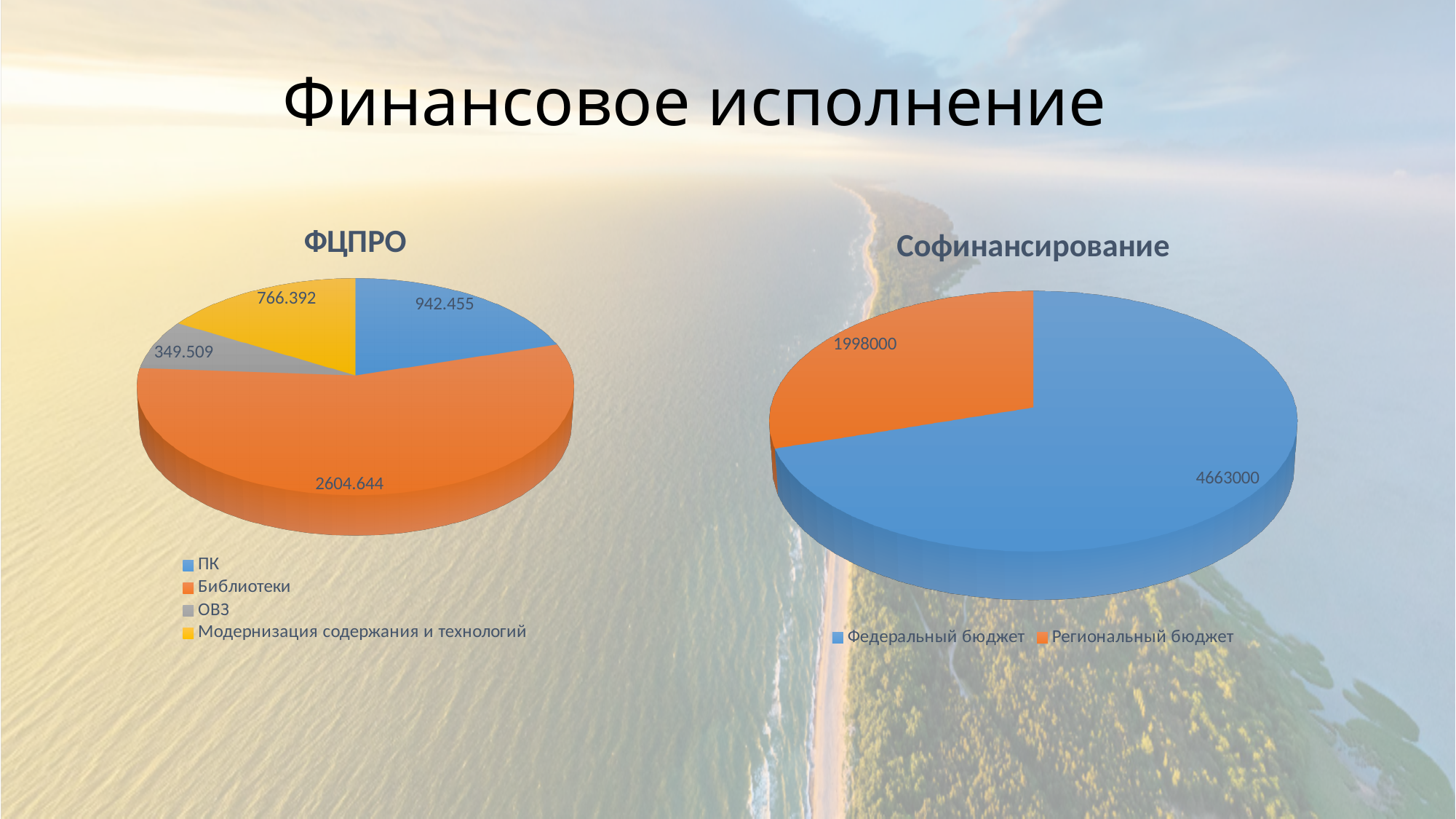
In the ФЦПРО chart, what is the value for Библиотеки? 2604.644 In the Софинансирование chart, what is the value for Федеральный бюджет? 4663000 In the ФЦПРО chart, what is the value for ОВЗ? 349.509 In the ФЦПРО chart, how many categories are shown? 4 In the Софинансирование chart, what is the difference between Федеральный бюджет and Региональный бюджет? 2665000 What type of chart is the Софинансирование chart? Pie chart In the Софинансирование chart, what is the value for Региональный бюджет? 1998000 In the ФЦПРО chart, which category has the smallest slice? ОВЗ In the Софинансирование chart, which is larger: Федеральный бюджет or Региональный бюджет? Федеральный бюджет In the ФЦПРО chart, which category has the largest slice? Библиотеки In the ФЦПРО chart, what is the value for Модернизация содержания и технологий? 766.392 In the ФЦПРО chart, what is the difference between the values for Библиотеки and ПК? 1662.189